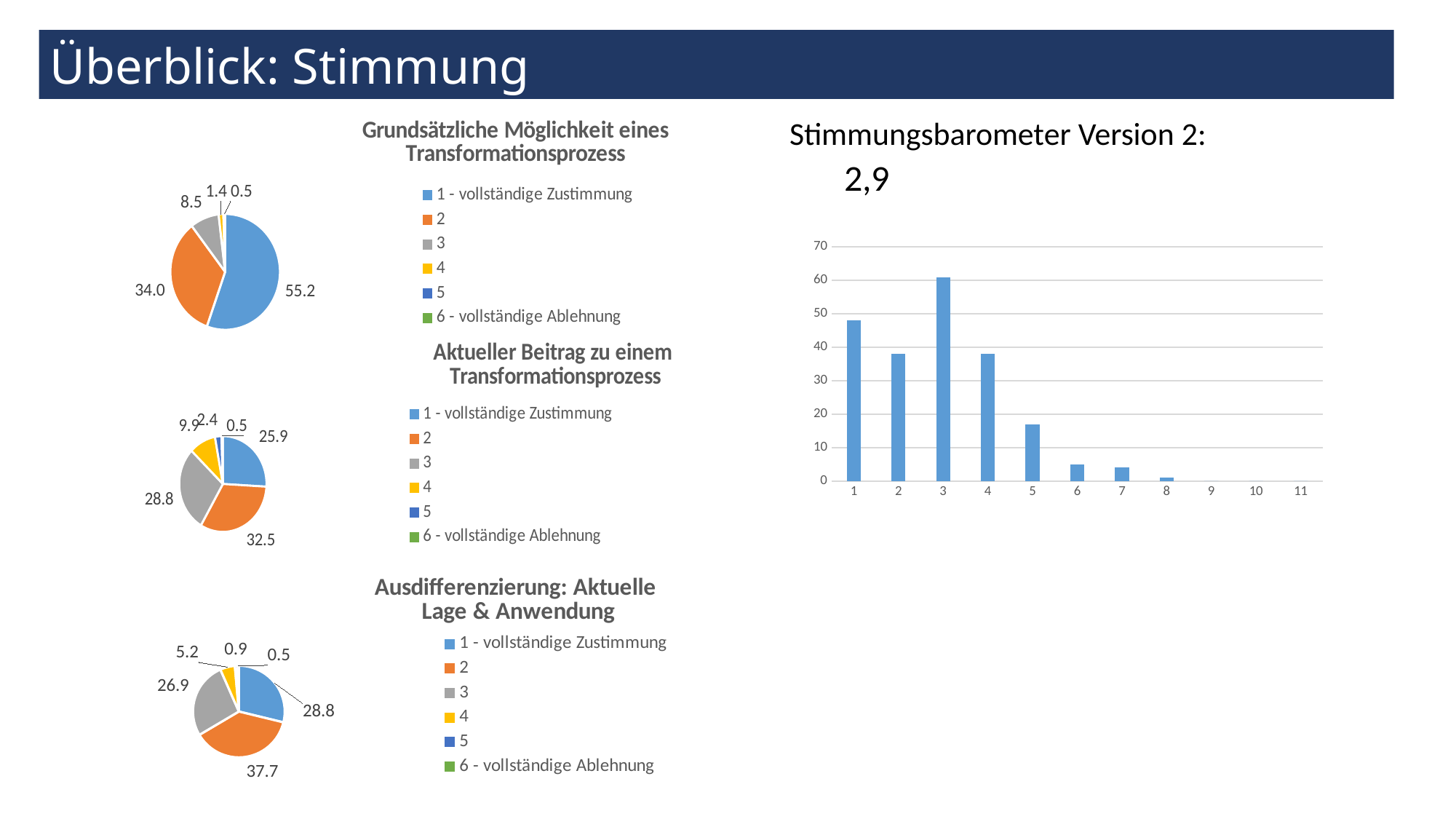
In the pie chart 'Grundsätzliche Möglichkeit eines Transformationsprozess', what is the value for category 3? 8.5 How many entries does the legend of the pie chart 'Grundsätzliche Möglichkeit eines Transformationsprozess' list? 6 In the pie chart 'Aktueller Beitrag zu einem Transformationsprozess', which category has the largest slice? 2 In the pie chart 'Aktueller Beitrag zu einem Transformationsprozess', what is the value for category 2? 32.5 In the pie chart 'Ausdifferenzierung: Aktuelle Lage & Anwendung', what is the difference between the values for category 2 and '1 - vollständige Zustimmung'? 8.9 What kind of chart is shown under 'Stimmungsbarometer Version 2'? bar chart In the pie chart 'Ausdifferenzierung: Aktuelle Lage & Anwendung', what is the value for category 2? 37.7 In the 'Stimmungsbarometer Version 2' chart, which category has the highest bar? 3 In the 'Stimmungsbarometer Version 2' chart, is the value for category 1 greater or less than 40? greater In the pie chart 'Ausdifferenzierung: Aktuelle Lage & Anwendung', which is larger: the value for '1 - vollständige Zustimmung' or for category 3? 1 - vollständige Zustimmung In the pie chart 'Grundsätzliche Möglichkeit eines Transformationsprozess', what is the value for '1 - vollständige Zustimmung'? 55.2 In the pie chart 'Grundsätzliche Möglichkeit eines Transformationsprozess', which category has the largest slice? 1 - vollständige Zustimmung